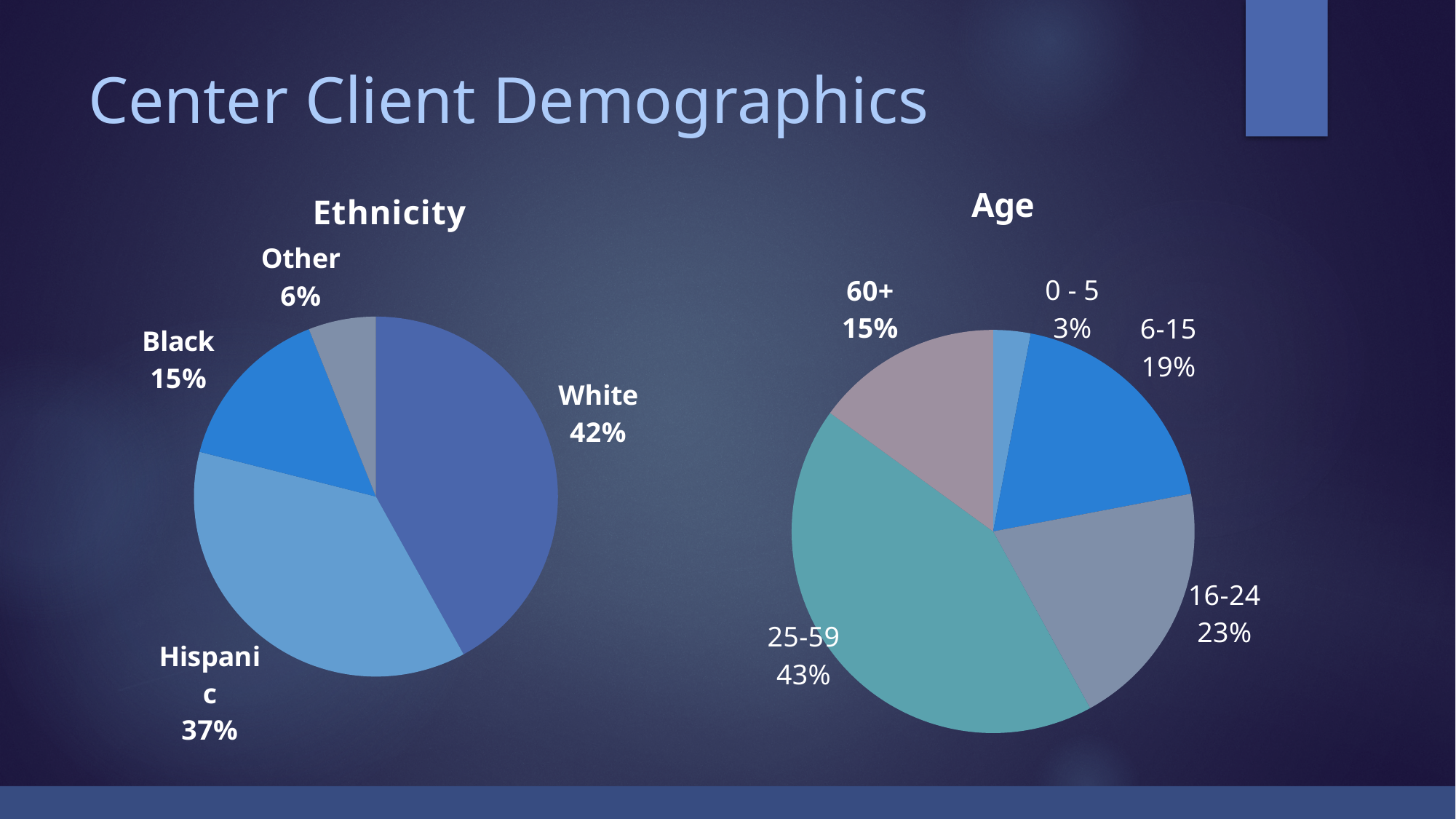
In the Ethnicity chart, which category has the smallest share? Other In the Ethnicity chart, what percentage is shown for White? 42% In the Ethnicity chart, which category has the largest share? White In the Age chart, which age group has the largest share? 25-59 In the Ethnicity chart, what percentage is shown for Hispanic? 37% In the Age chart, what percentage is shown for 6-15? 19% In the Ethnicity chart, what is the difference between the White and Hispanic shares? 5% In the Age chart, which is larger, the share for 16-24 or the share for 6-15? 16-24 In the Age chart, which age group has the smallest share? 0 - 5 What type of chart is the Age chart? Pie chart How many categories does the Ethnicity chart show? 4 In the Age chart, what percentage is shown for 60+? 15%